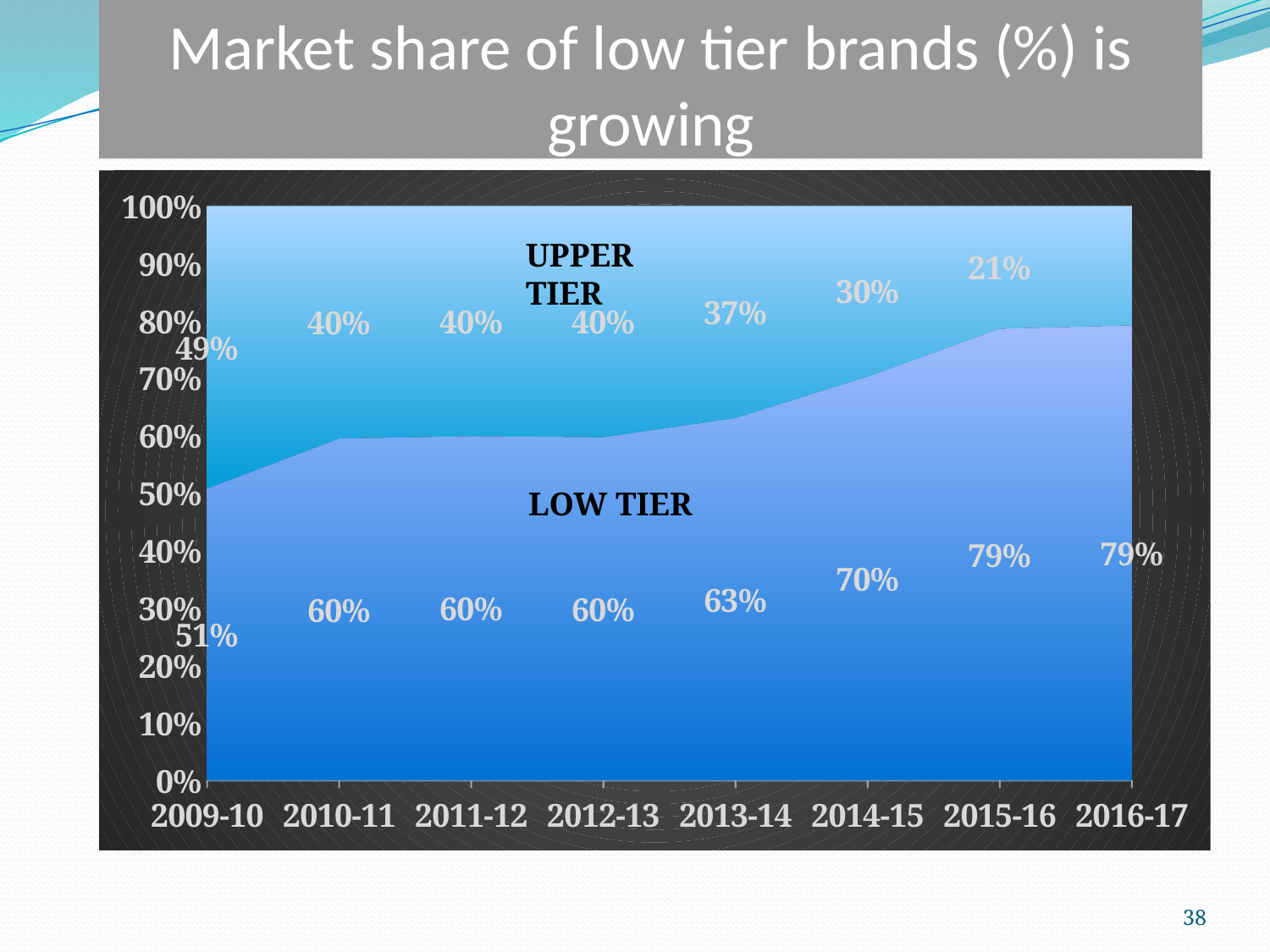
Does the low tier market share rise or fall from 2009-10 to 2016-17? Rise What is the market share of upper tier brands in 2014-15? 30% Which is larger in 2012-13, the low tier share or the upper tier share? Low tier What is the market share of low tier brands in 2015-16? 79% By how many percentage points did the low tier share grow from 2009-10 to 2016-17? 28 What kind of chart is shown on the slide? Area chart What is the market share of upper tier brands in 2013-14? 37% In which year is the low tier market share lowest? 2009-10 What is the market share of low tier brands in 2009-10? 51% In which year is the upper tier market share highest? 2009-10 How many years are shown on the x axis? 8 What is the title of the slide? Market share of low tier brands (%) is growing